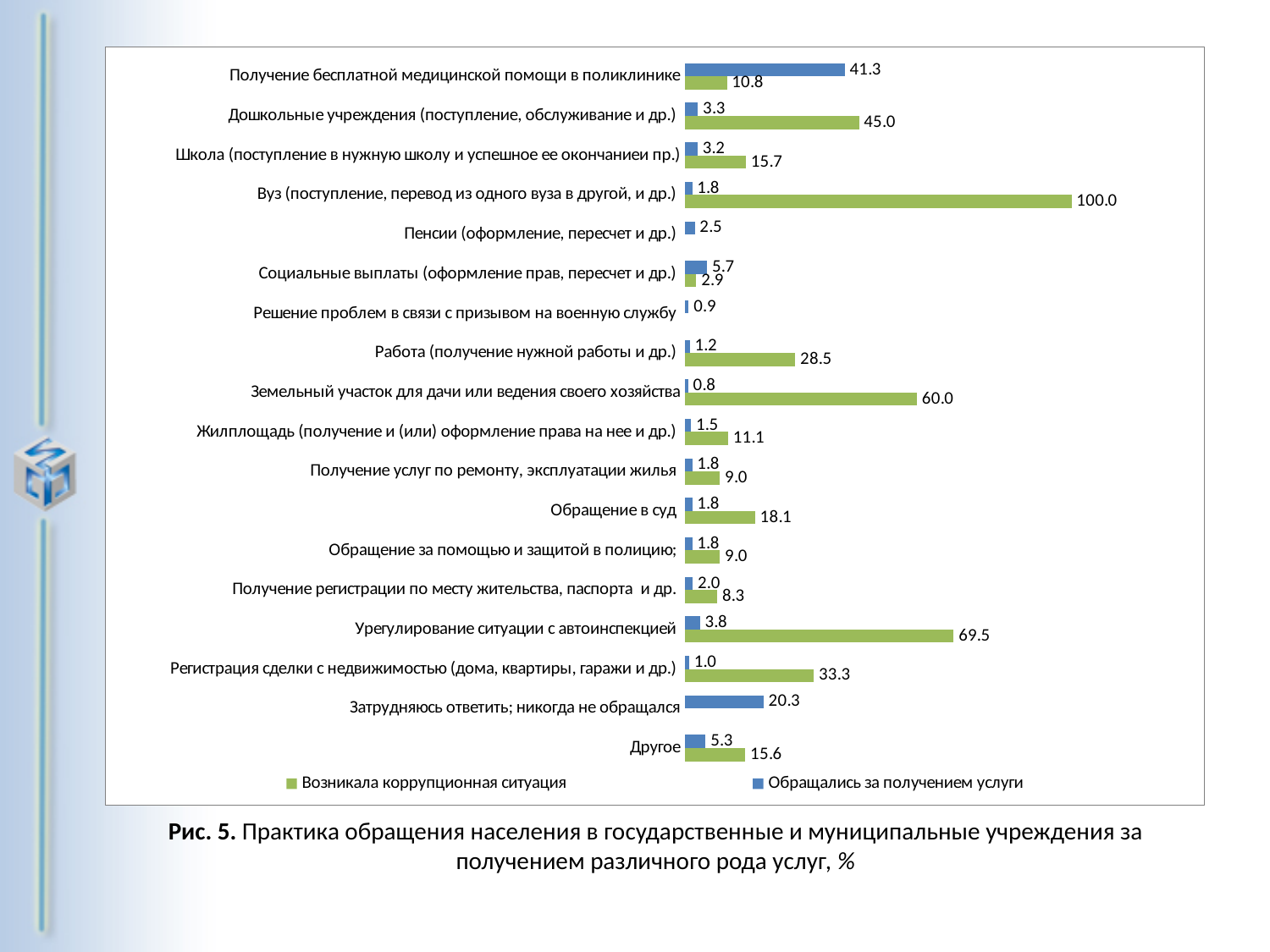
What is the value of "Обращались за получением услуги" for "Получение бесплатной медицинской помощи в поликлинике"? 41.3 How many series does the legend list? 2 What type of chart is shown on the slide? bar chart What is the value of "Возникала коррупционная ситуация" for "Урегулирование ситуации с автоинспекцией"? 69.5 Which is larger for "Социальные выплаты (оформление прав, пересчет и др.)": "Обращались за получением услуги" or "Возникала коррупционная ситуация"? Обращались за получением услуги Which category has the highest value for "Обращались за получением услуги"? Получение бесплатной медицинской помощи в поликлинике What is the value of "Возникала коррупционная ситуация" for "Вуз (поступление, перевод из одного вуза в другой, и др.)"? 100.0 What is the difference between the "Возникала коррупционная ситуация" values for "Земельный участок для дачи или ведения своего хозяйства" and "Дошкольные учреждения (поступление, обслуживание и др.)"? 15.0 What is the value of "Обращались за получением услуги" for "Затрудняюсь ответить; никогда не обращался"? 20.3 How many categories are shown on the chart? 18 Which category has the lowest value for "Обращались за получением услуги"? Земельный участок для дачи или ведения своего хозяйства Which series is shown in green in the legend? Возникала коррупционная ситуация